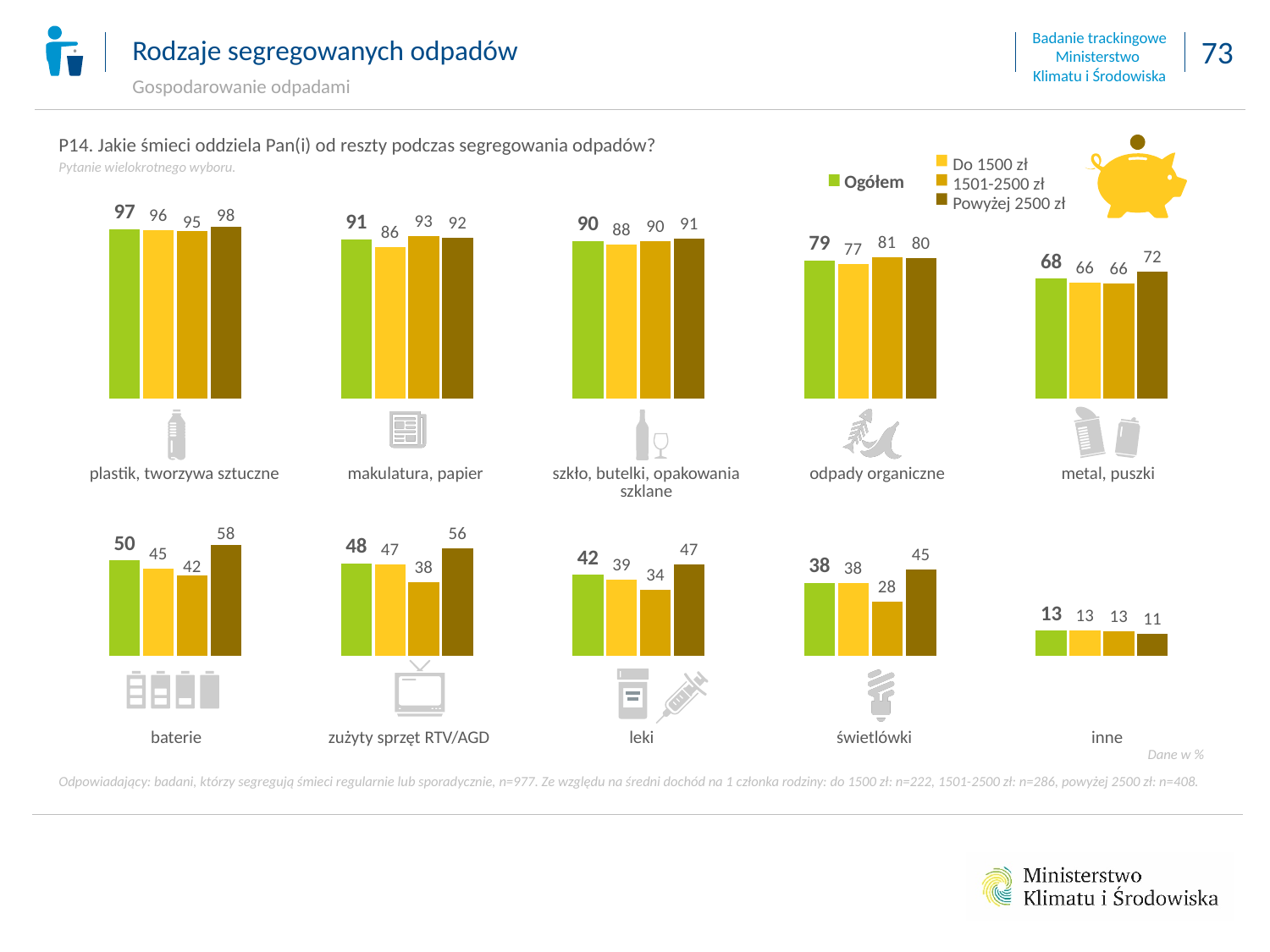
In the 'zużyty sprzęt RTV/AGD' chart, which series has the highest value? Powyżej 2500 zł In the 'świetlówki' chart, what is the difference between the 'Powyżej 2500 zł' value and the '1501-2500 zł' value? 17 In the 'metal, puszki' chart, which is larger: the 'Ogółem' value or the 'Powyżej 2500 zł' value? Powyżej 2500 zł Which series is shown in green in the legend? Ogółem In the 'makulatura, papier' chart, which series has the lowest value? Do 1500 zł How many separate bar charts (waste categories) are shown on the slide? 10 What kind of chart is used for the 'odpady organiczne' data? bar chart In the 'baterie' chart, what is the value for the 'Powyżej 2500 zł' series? 58 In the 'plastik, tworzywa sztuczne' chart, what is the value for the 'Ogółem' series? 97 How many series does the legend list? 4 In the 'inne' chart, what is the value for the 'Powyżej 2500 zł' series? 11 In the 'leki' chart, what is the value for the '1501-2500 zł' series? 34